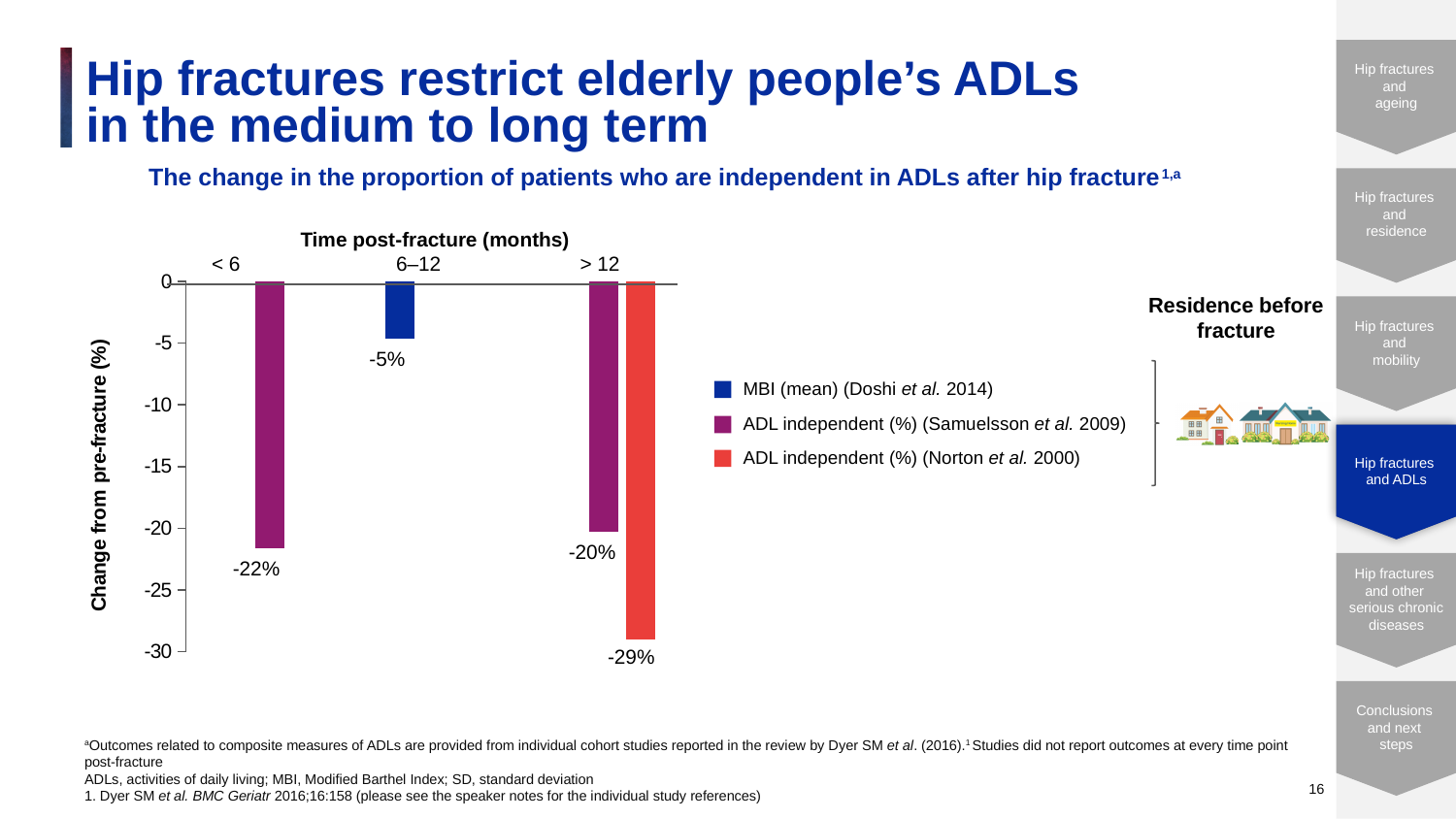
At > 12 months post-fracture, which study shows a larger decline: Samuelsson et al. 2009 or Norton et al. 2000? Norton et al. 2000 What is the change from pre-fracture for ADL independent (%) (Norton et al. 2000) at > 12 months post-fracture? -29% What is the label of the y axis? Change from pre-fracture (%) Which bar shows the smallest decline from pre-fracture? MBI (mean) (Doshi et al. 2014) at 6–12 months (-5%) How many time post-fracture categories are shown on the x axis? 3 How many series does the legend list? 3 Which bar shows the largest decline from pre-fracture? ADL independent (%) (Norton et al. 2000) at > 12 months (-29%) What is the change from pre-fracture for MBI (mean) (Doshi et al. 2014) at 6–12 months post-fracture? -5% What is the change from pre-fracture for ADL independent (%) (Samuelsson et al. 2009) at < 6 months post-fracture? -22% What is the difference between the Norton et al. 2000 value and the Samuelsson et al. 2009 value at > 12 months post-fracture? 9 percentage points What type of chart is shown on the slide? Bar chart What is the change from pre-fracture for ADL independent (%) (Samuelsson et al. 2009) at > 12 months post-fracture? -20%